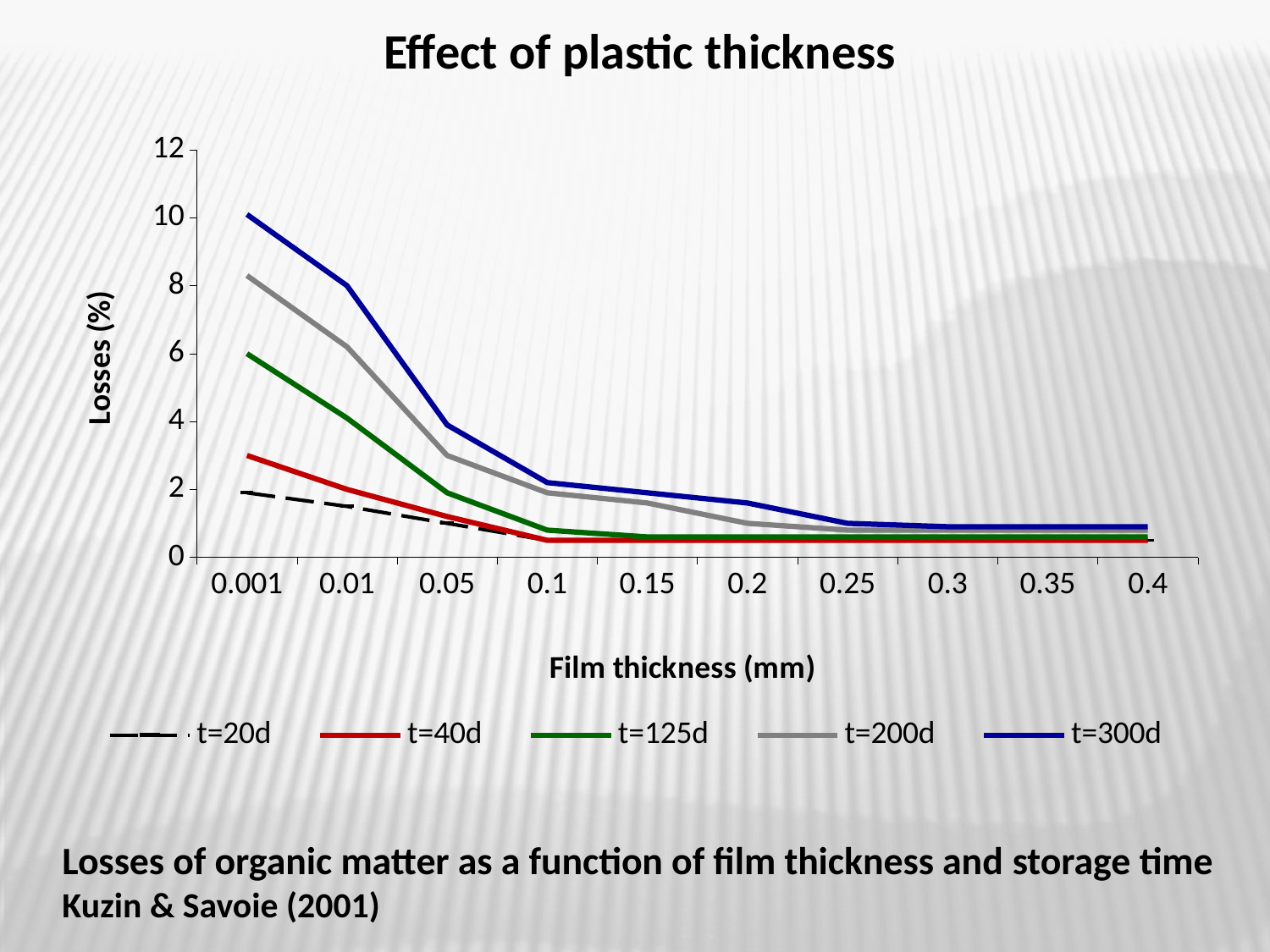
Which series has the highest losses at a film thickness of 0.001 mm? t=300d Is the value for t=125d at 0.05 mm greater or less than 4? less How many series does the legend list? 5 How many film thickness values are shown on the x axis? 10 Do the losses for t=300d rise or fall as film thickness increases along the x axis? fall What is the title of the chart? Effect of plastic thickness What is the label of the y axis? Losses (%) Which series has the lowest losses at a film thickness of 0.001 mm? t=20d At a film thickness of 0.05 mm, which series has higher losses, t=200d or t=40d? t=200d What kind of chart is shown on the slide? line chart Is the value for t=300d at 0.01 mm greater or less than 6? greater